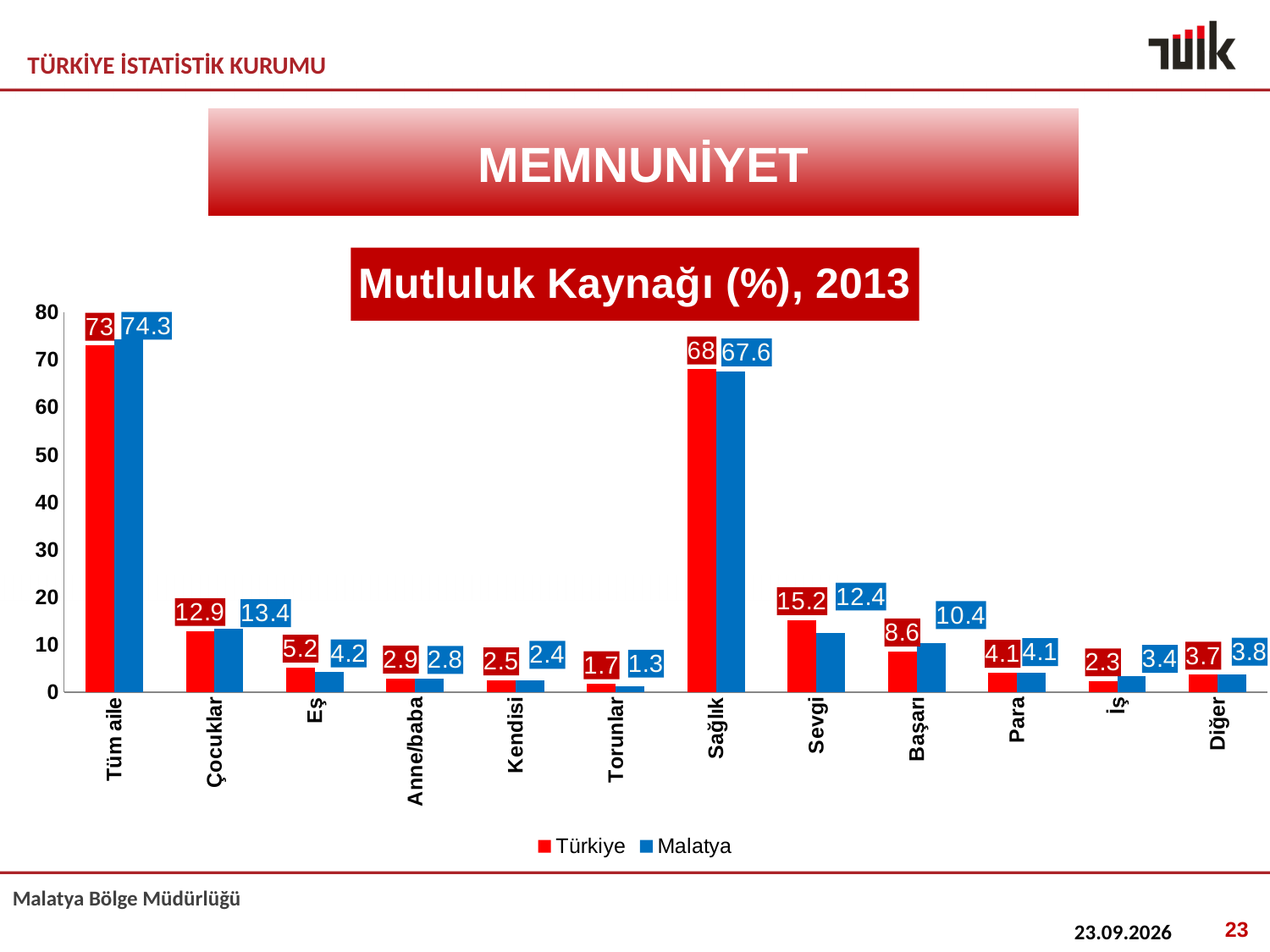
What is the Türkiye value for Sağlık? 68 Which is larger for Başarı, the Türkiye value or the Malatya value? Malatya What is the difference between the Malatya and Türkiye values for Sevgi? 2.8 What is the title of the chart? Mutluluk Kaynağı (%), 2013 What is the Malatya value for Çocuklar? 13.4 How many categories are shown on the x axis? 12 Which category has the lowest Türkiye value? Torunlar Is the Türkiye value for Sağlık greater or less than 60? greater How many series does the legend list? 2 What is the Malatya value for Başarı? 10.4 What kind of chart is shown on the slide? Bar chart Which category has the highest Malatya value? Tüm aile